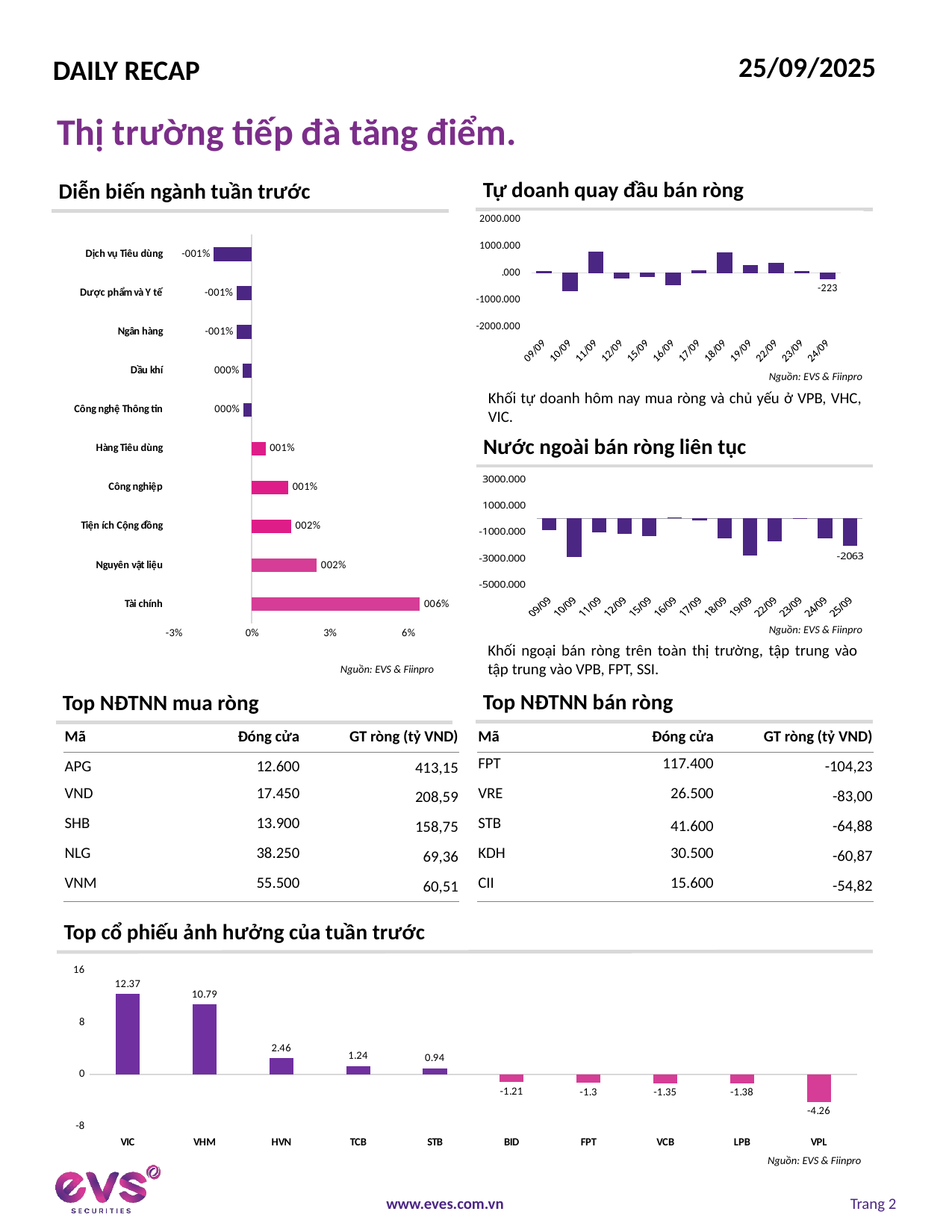
In the 'Diễn biến ngành tuần trước' chart, which sector has the highest value? Tài chính In the 'Top cổ phiếu ảnh hưởng của tuần trước' chart, what is the value for VIC? 12.37 In the 'Nước ngoài bán ròng liên tục' chart, is the value for 10/09 greater or less than -1000.000? less In the 'Top cổ phiếu ảnh hưởng của tuần trước' chart, what is the difference between the values for VIC and VHM? 1.58 In the 'Top cổ phiếu ảnh hưởng của tuần trước' chart, which stock has the lowest value? VPL In the 'Tự doanh quay đầu bán ròng' chart, what is the labelled value for 24/09? -223 In the 'Tự doanh quay đầu bán ròng' chart, is the value for 11/09 greater or less than 1000.000? less In the 'Diễn biến ngành tuần trước' chart, what is the value for Tài chính? 006% In the 'Nước ngoài bán ròng liên tục' chart, what is the labelled value for 25/09? -2063 What kind of chart is 'Diễn biến ngành tuần trước'? Bar chart In the 'Top cổ phiếu ảnh hưởng của tuần trước' chart, which is larger, HVN or TCB? HVN How many sectors are shown in the 'Diễn biến ngành tuần trước' chart? 10